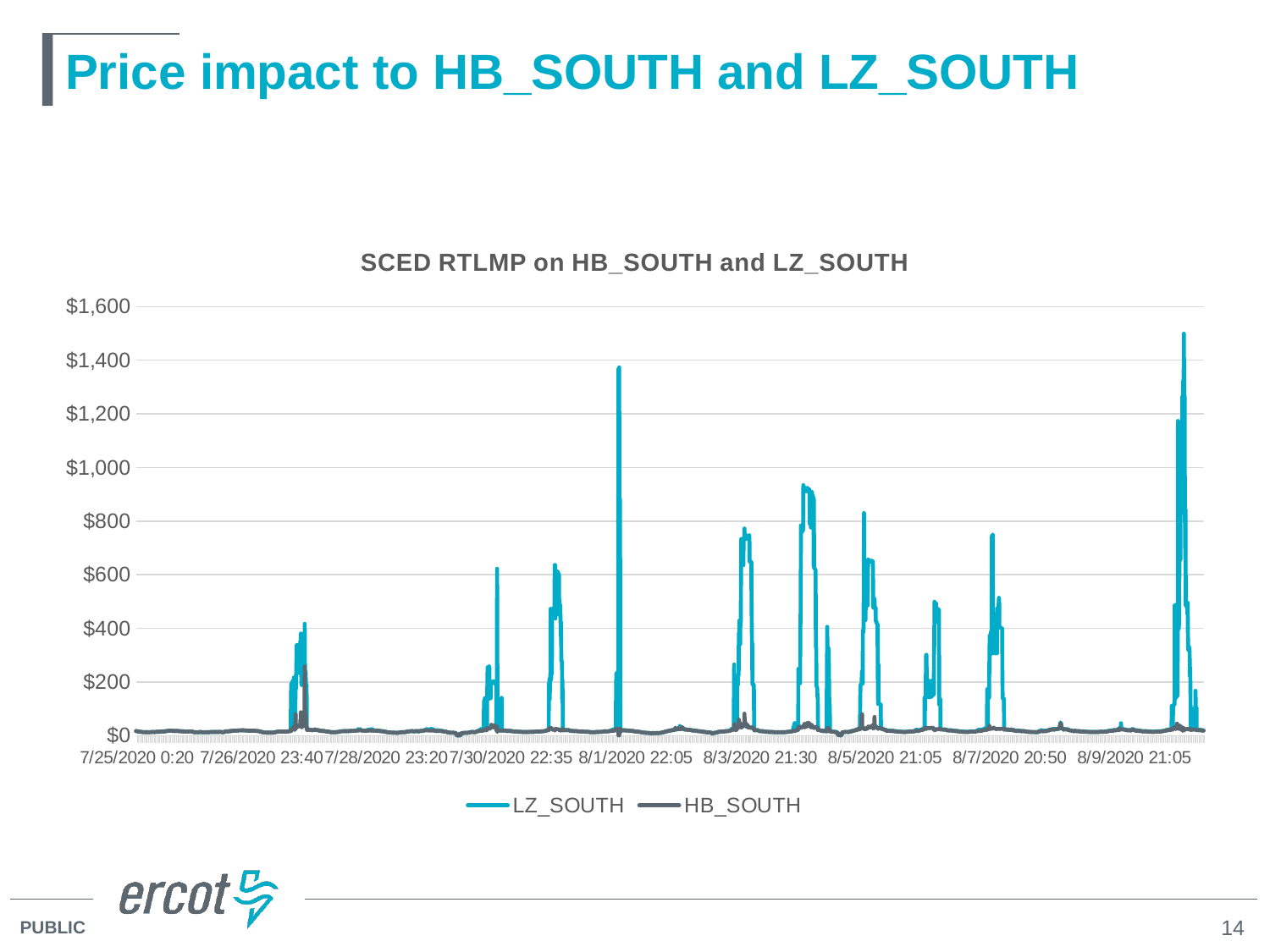
How many date labels are shown along the x axis? 9 Is the highest LZ_SOUTH spike near 8/9/2020 greater or less than $1,400? greater Is the LZ_SOUTH spike near 7/26/2020 greater or less than $600? less Which series reaches higher price spikes, LZ_SOUTH or HB_SOUTH? LZ_SOUTH Which series stays close to $0 for most of the period? HB_SOUTH How many series does the legend list? 2 What kind of chart is shown on the slide? Line chart What is the title of the chart? SCED RTLMP on HB_SOUTH and LZ_SOUTH Is the HB_SOUTH series ever greater or less than $200 across the whole period? less What is the highest value shown on the vertical axis? $1,600 Which two series are listed in the chart legend? LZ_SOUTH and HB_SOUTH